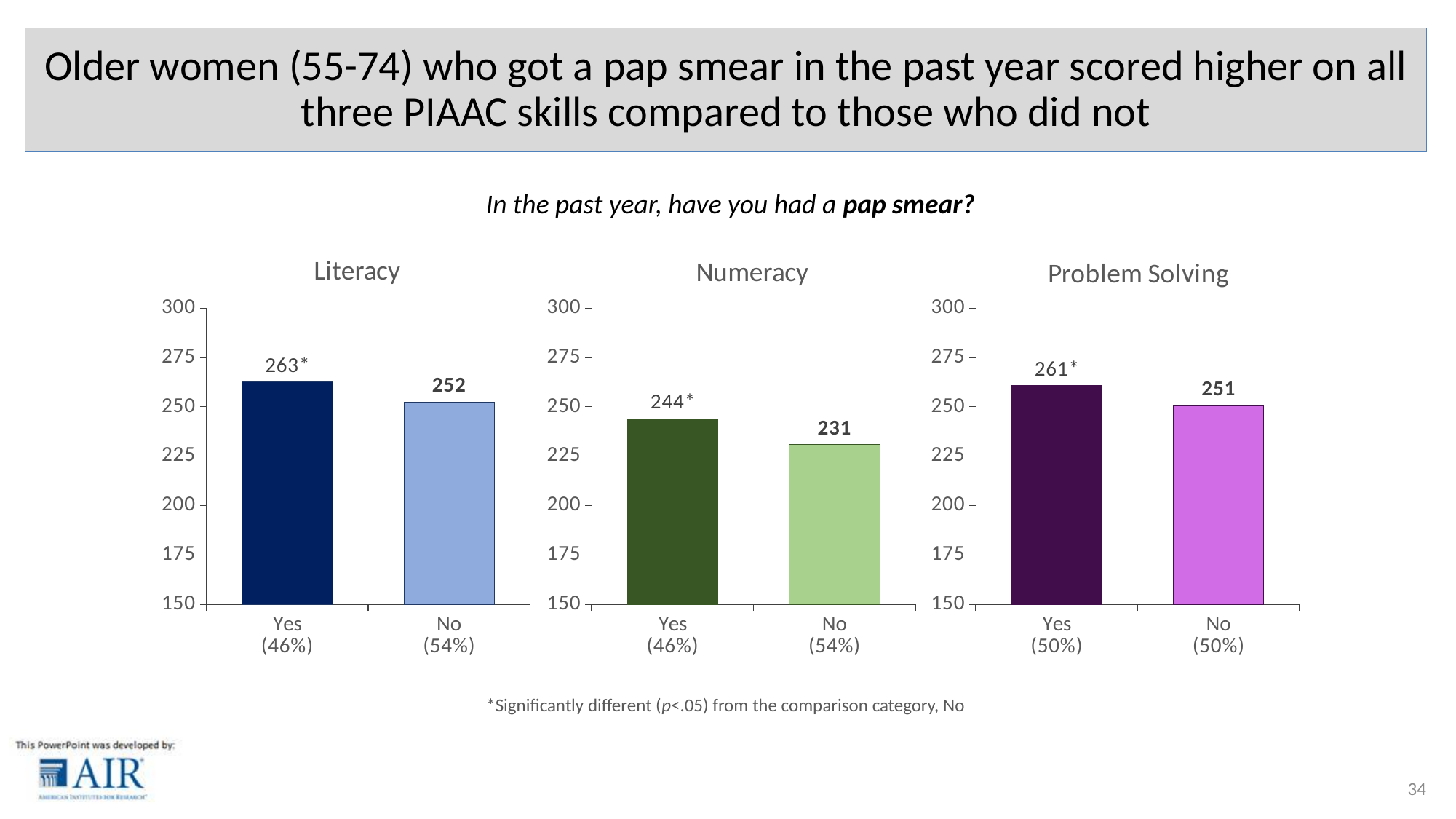
What kind of chart is the Numeracy chart? bar chart In the Numeracy chart, what is the value for Yes (46%)? 244 In the Literacy chart, what is the value for Yes (46%)? 263 How many bars are shown in the Literacy chart? 2 In the Problem Solving chart, what is the value for No (50%)? 251 In the Problem Solving chart, what is the value for Yes (50%)? 261 In the Numeracy chart, what is the difference between the Yes and No values? 13 In the Problem Solving chart, which category has the lowest value? No (50%) In the Literacy chart, what is the value for No (54%)? 252 In the Numeracy chart, is the value for No greater or less than 250? less In the Numeracy chart, what is the value for No (54%)? 231 In the Literacy chart, which category has the higher value, Yes or No? Yes